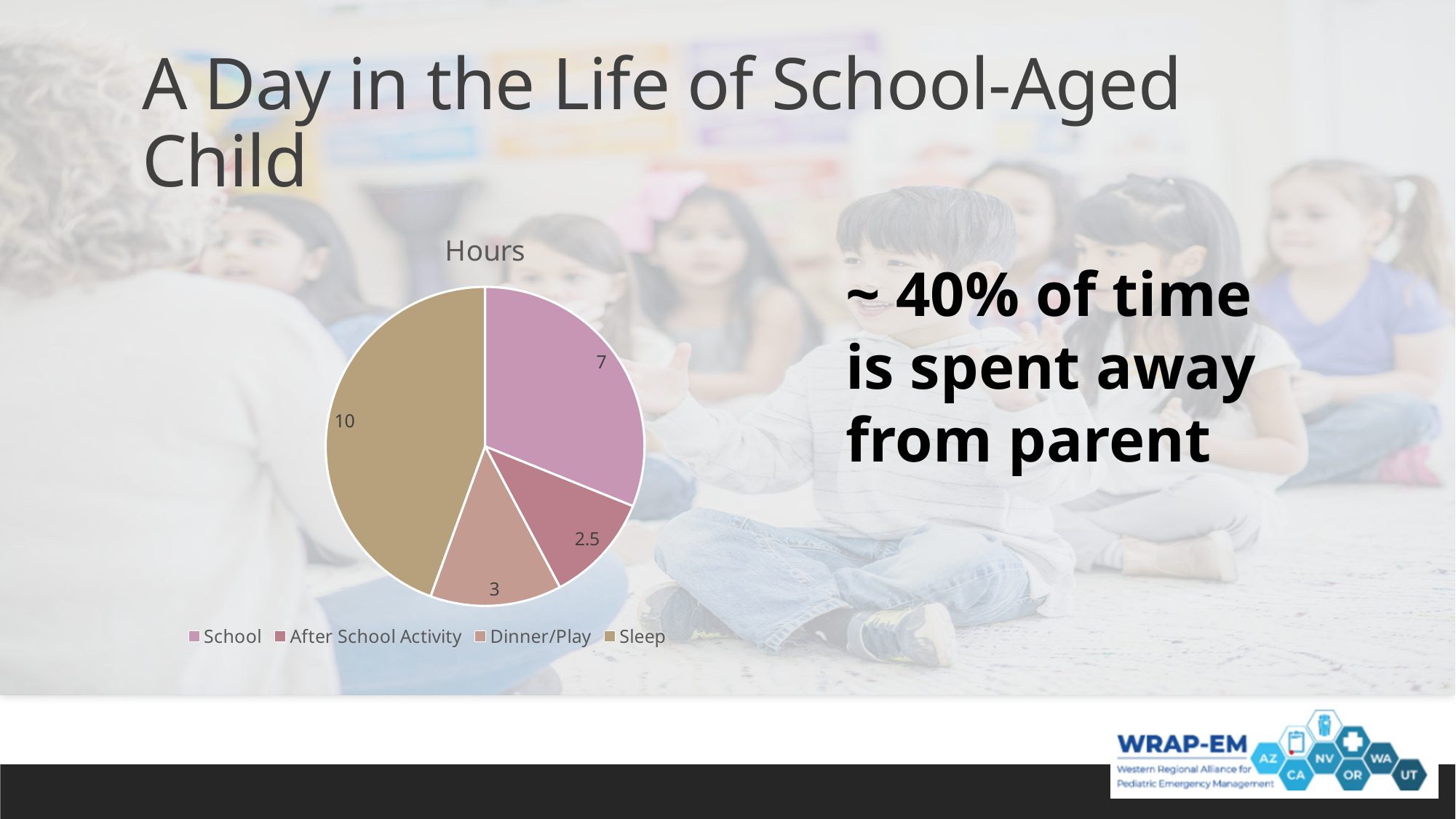
How many hours are shown for Sleep? 10 What is the total of all the values shown in the pie chart? 22.5 How many hours are shown for After School Activity? 2.5 What type of chart is shown on the slide? pie chart Which category has the smallest slice of the pie? After School Activity How many hours are shown for Dinner/Play? 3 Which is larger, the value for Dinner/Play or the value for After School Activity? Dinner/Play What is the difference in hours between Sleep and School? 3 What is the title of the chart? Hours How many hours are shown for School? 7 Which category has the largest slice of the pie? Sleep How many categories does the legend list? 4